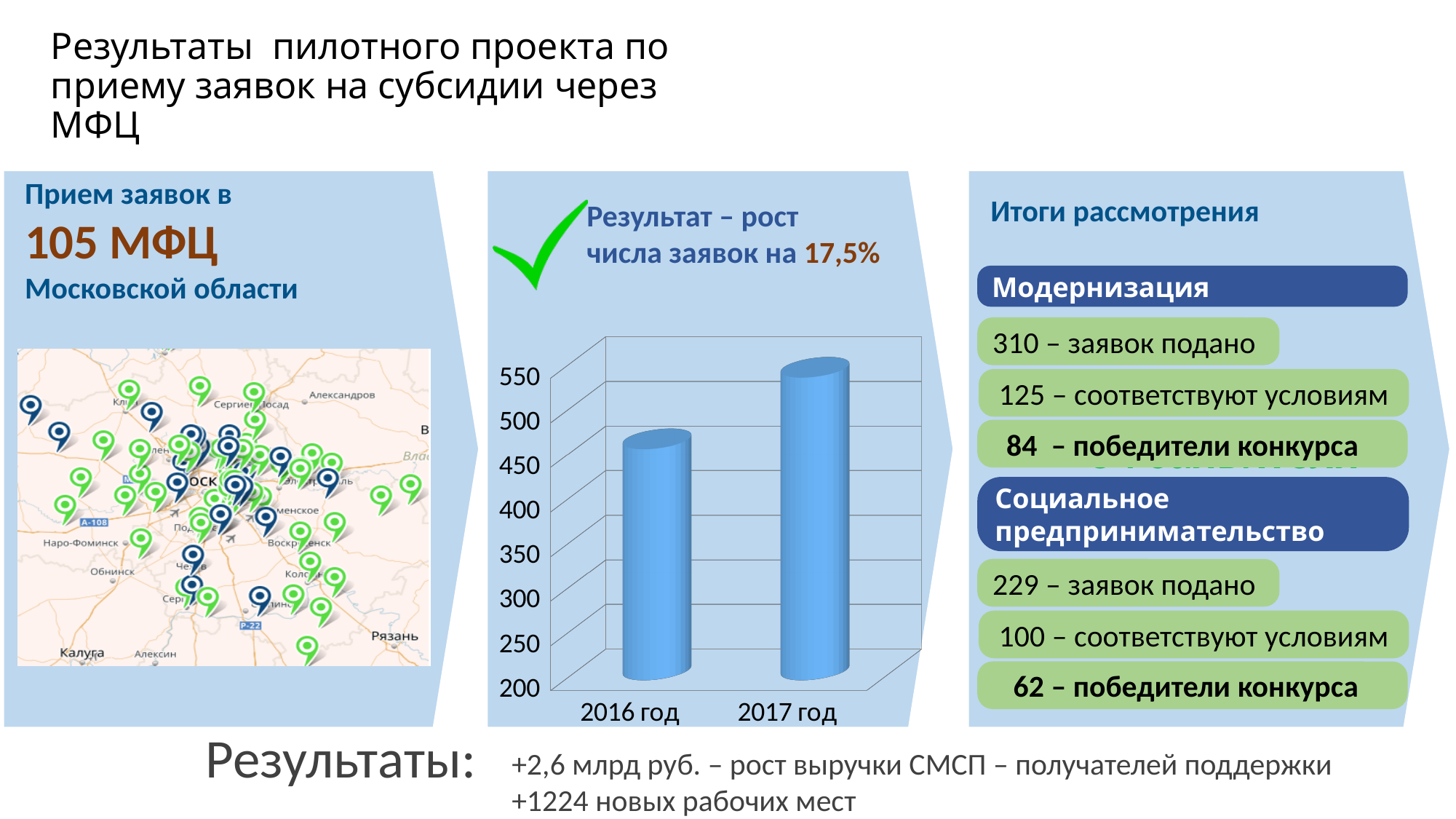
What is the highest value shown on the chart's vertical axis? 550 Is the value for 2016 год greater or less than 500? less What is the lowest value shown on the chart's vertical axis? 200 Do the values rise or fall from 2016 год to 2017 год? rise Is the value for 2016 год greater or less than 400? greater How many categories (bars) does the chart show? 2 Is the bar for 2016 год or the bar for 2017 год larger? 2017 год Which year has the taller bar in the chart? 2017 год What kind of chart is shown in the middle panel of the slide? bar chart Is the value for 2017 год greater or less than 500? greater Which year has the shorter bar in the chart? 2016 год